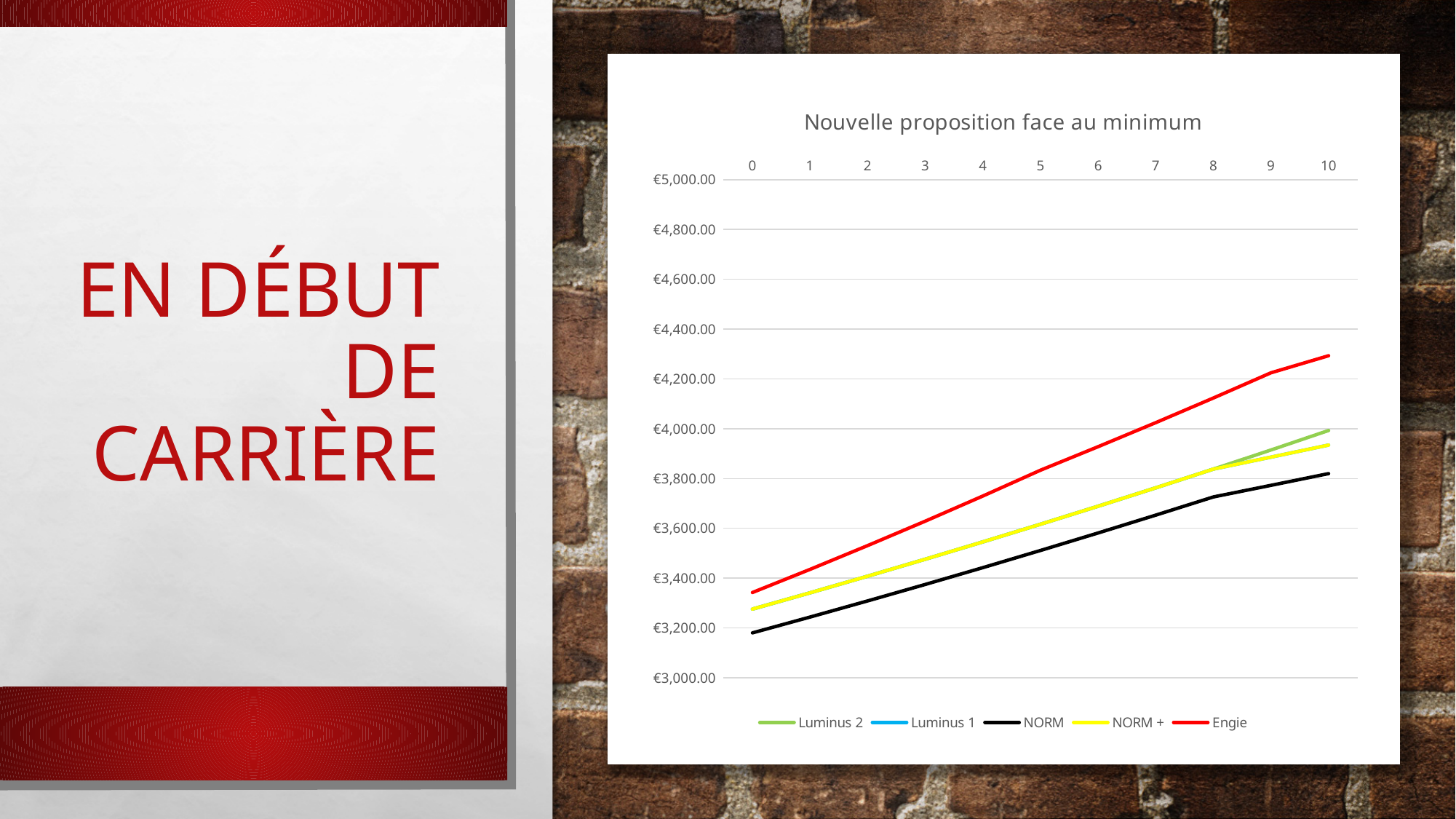
Does the Engie line rise or fall as x increases from 0 to 10? rise How many series does the chart legend list? 5 Is the value for NORM at x = 0 greater or less than €3,200.00? less What kind of chart is shown on the slide? line chart What colour is the line for the NORM series? black Is the value for Engie at x = 10 greater or less than €4,200.00? greater Which series has the highest value at x = 10? Engie Is the value for Engie at x = 0 greater or less than €3,400.00? less What is the title of the chart? Nouvelle proposition face au minimum At x = 5, which is larger: the value for Engie or the value for NORM? Engie Which series has the lowest value at x = 10? NORM How many points are marked along the x axis of the chart? 11